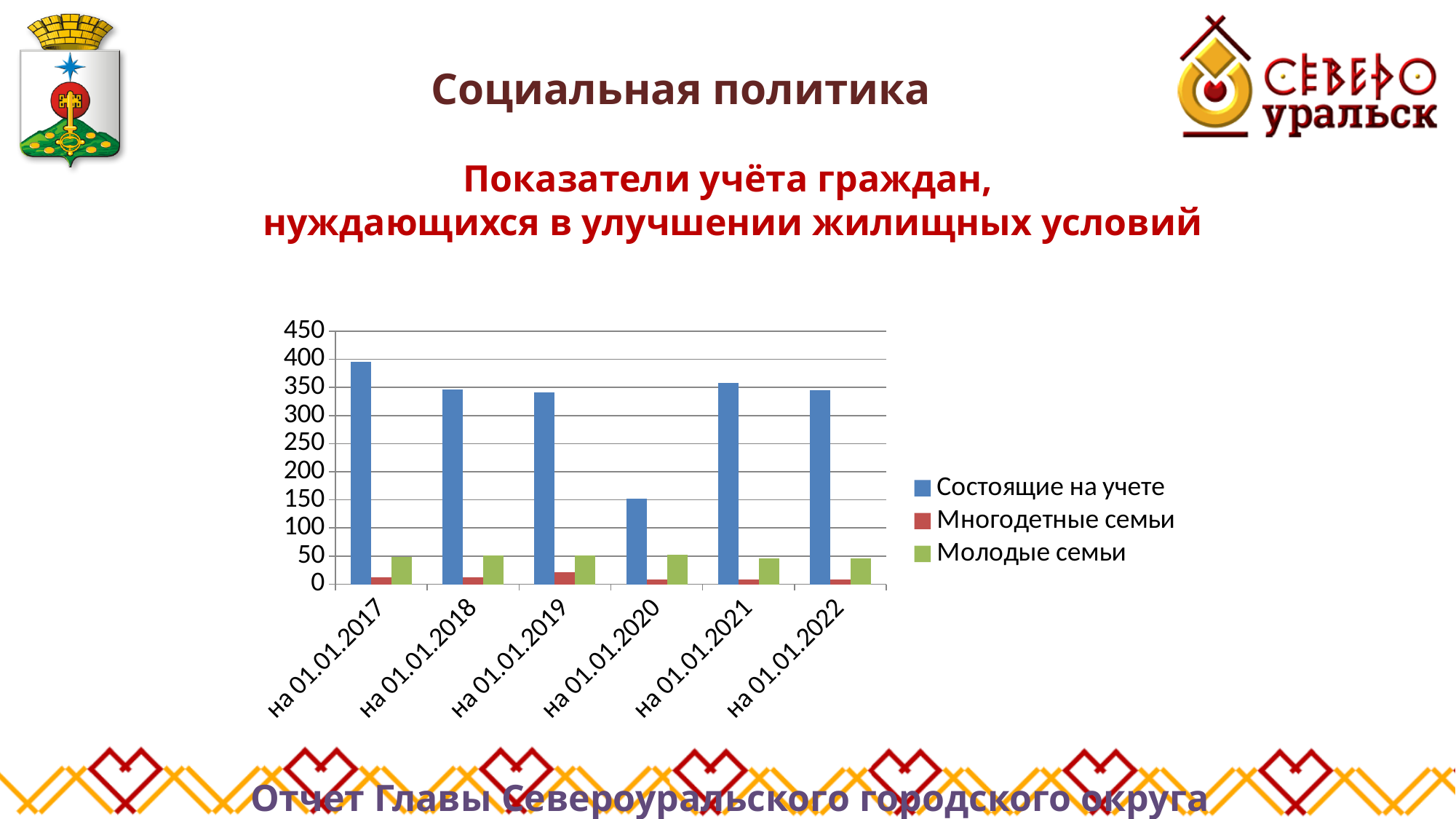
Is the value for Состоящие на учете на 01.01.2017 greater or less than 350? greater How many series does the legend list? 3 Which is larger: the value for Состоящие на учете на 01.01.2021 or на 01.01.2020? на 01.01.2021 Does the value for Состоящие на учете rise or fall from 01.01.2017 to 01.01.2020? fall On which date is the value for Состоящие на учете the lowest? на 01.01.2020 Is the value for Молодые семьи на 01.01.2018 greater or less than 100? less Is the value for Состоящие на учете на 01.01.2020 greater or less than 200? less On which date is the value for Состоящие на учете the highest? на 01.01.2017 What kind of chart is shown on the slide? bar chart How many dates (categories) are shown on the x axis? 6 On which date is the value for Многодетные семьи the highest? на 01.01.2019 Which colour represents Молодые семьи in the legend? green